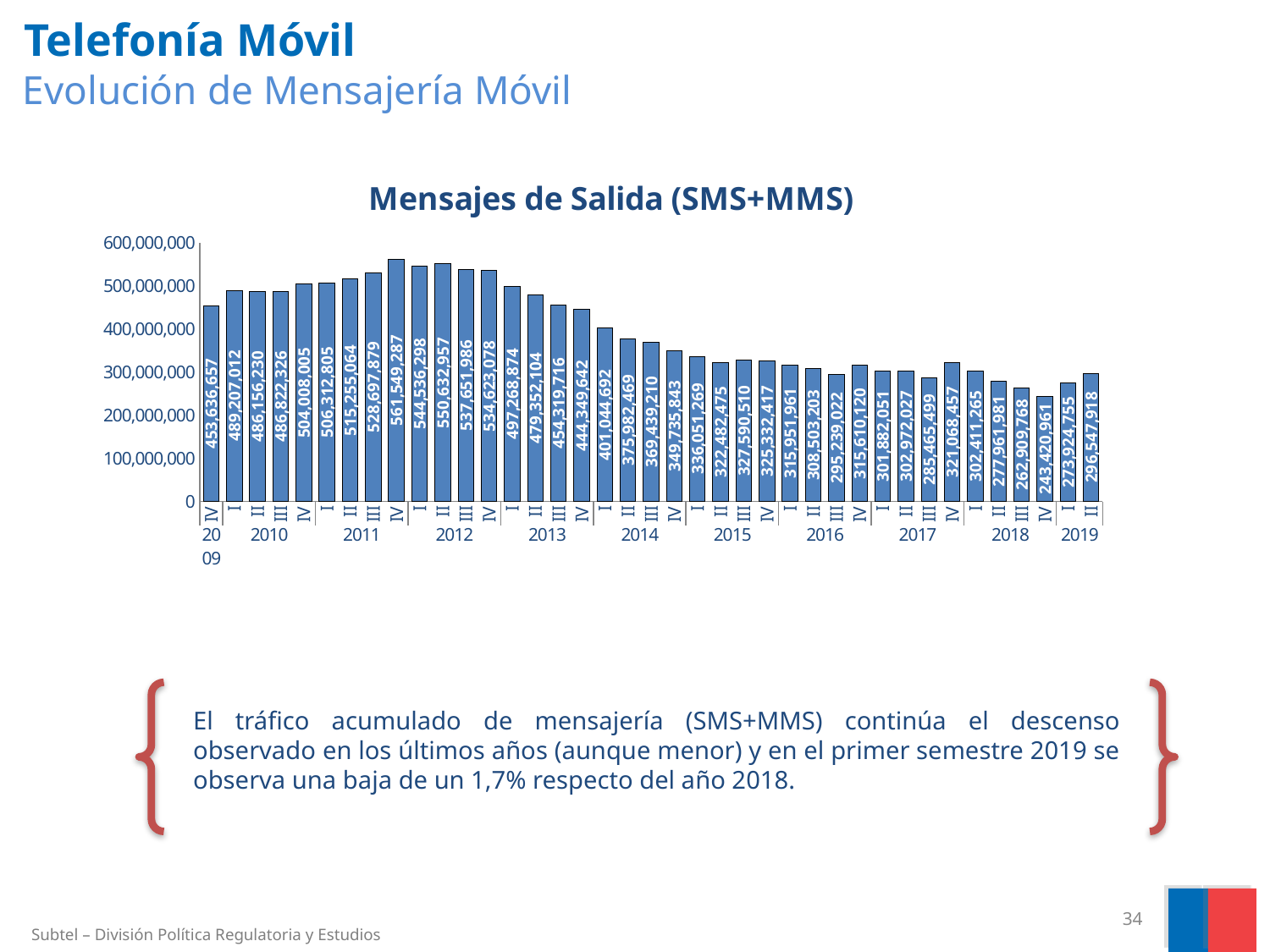
How many bars (quarters) are plotted in the chart? 39 Which quarter has the lowest number of outgoing messages? IV 2018 What is the value of outgoing messages for quarter II of 2019? 296,547,918 Is the value for quarter IV of 2009 greater or less than 400,000,000? greater What is the value of outgoing messages for quarter IV of 2018? 243,420,961 Which quarter has the highest number of outgoing messages? IV 2011 What type of chart is shown on the slide? Bar chart What is the difference between the values for quarter II of 2019 and quarter I of 2019? 22,623,163 What is the difference between the highest value (IV 2011) and the lowest value (IV 2018)? 318,128,326 What is the title of the chart? Mensajes de Salida (SMS+MMS) What is the value of outgoing messages for quarter IV of 2011? 561,549,287 Which is larger, the value for quarter I of 2013 or the value for quarter I of 2014? I 2013